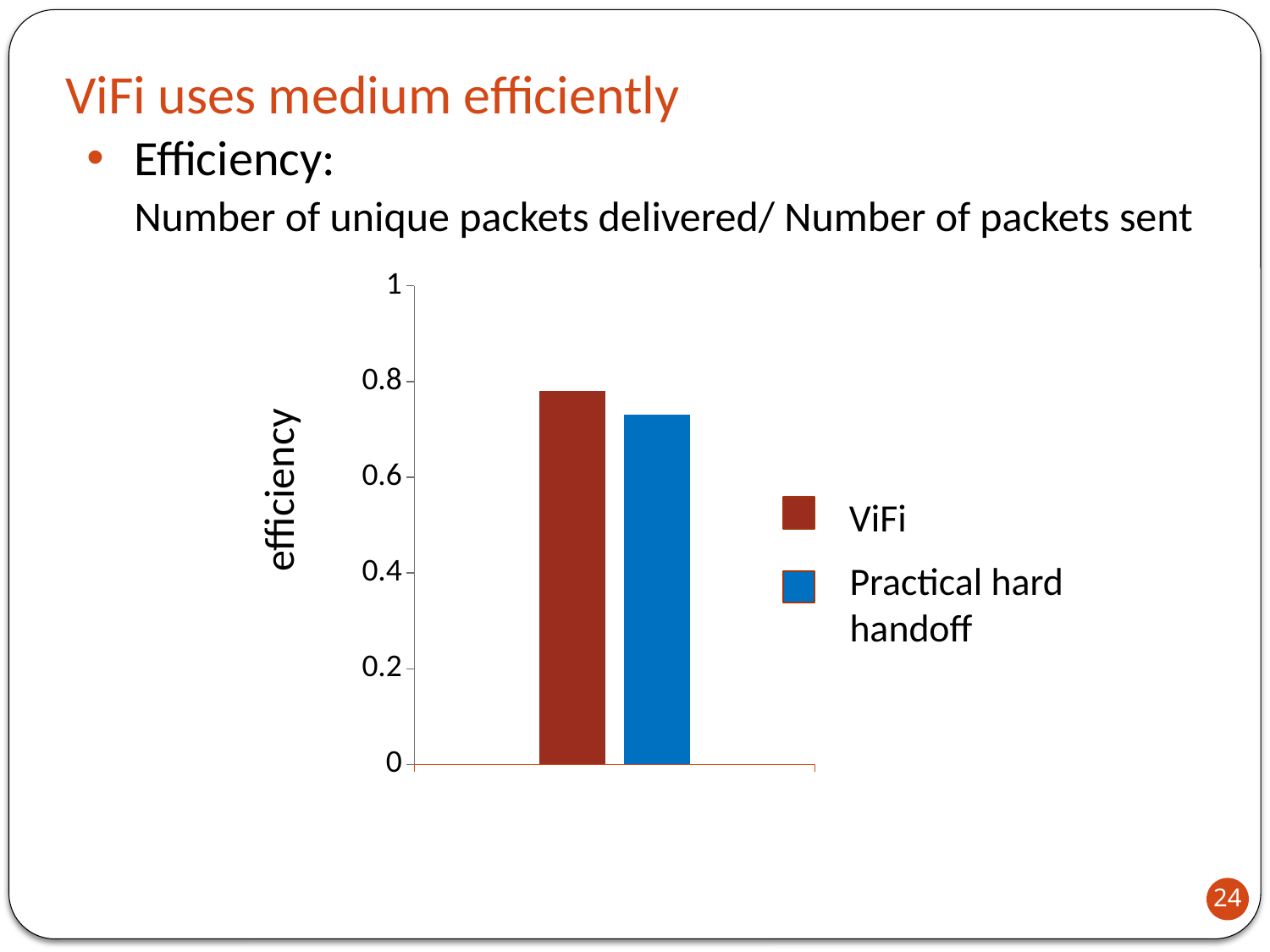
What colour is the bar for Practical hard handoff? blue What kind of chart is shown on the slide? bar chart Which series has the lowest efficiency? Practical hard handoff Which series has the higher efficiency, ViFi or Practical hard handoff? ViFi What is the label on the vertical axis of the chart? efficiency How many bars are plotted in the chart? 2 Which series has the highest efficiency? ViFi Is the efficiency for ViFi greater or less than 0.6? greater How many series does the legend list? 2 Is the efficiency for ViFi greater or less than 0.8? less Is the efficiency for Practical hard handoff greater or less than 0.6? greater